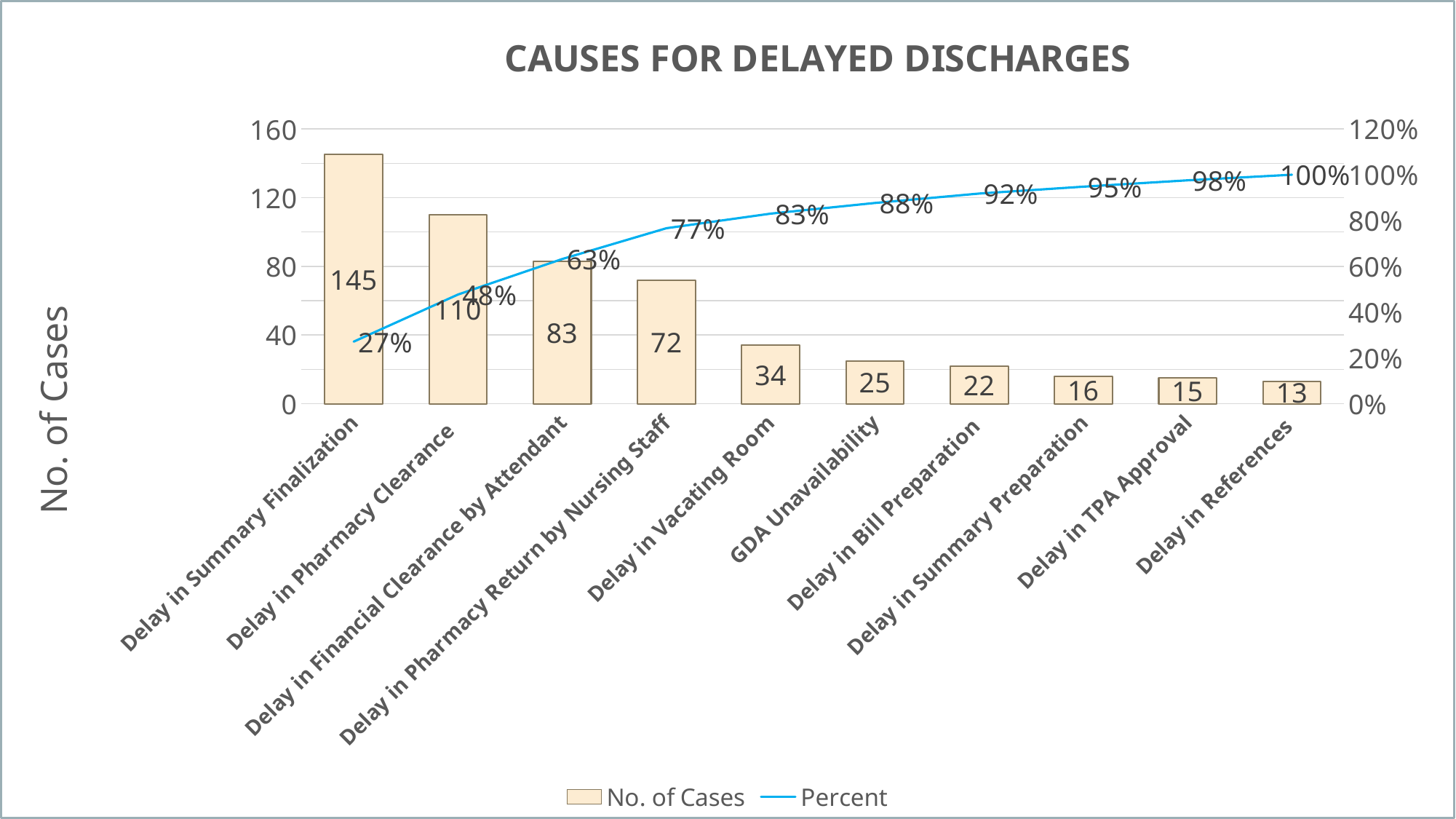
What is the cumulative percent value at Delay in Pharmacy Return by Nursing Staff? 77% Do the number of cases rise or fall from left to right along the x axis? Fall How many series does the legend list? 2 Which has more cases, Delay in Vacating Room or Delay in Bill Preparation? Delay in Vacating Room What is the number of cases for Delay in Summary Finalization? 145 Which cause has the lowest number of cases? Delay in References Which cause has the highest number of cases? Delay in Summary Finalization What is the number of cases for GDA Unavailability? 25 What kind of chart is this? Combined bar and line chart What is the title of the chart? CAUSES FOR DELAYED DISCHARGES How many causes are shown on the x axis? 10 What is the difference in number of cases between Delay in Pharmacy Clearance and Delay in Financial Clearance by Attendant? 27